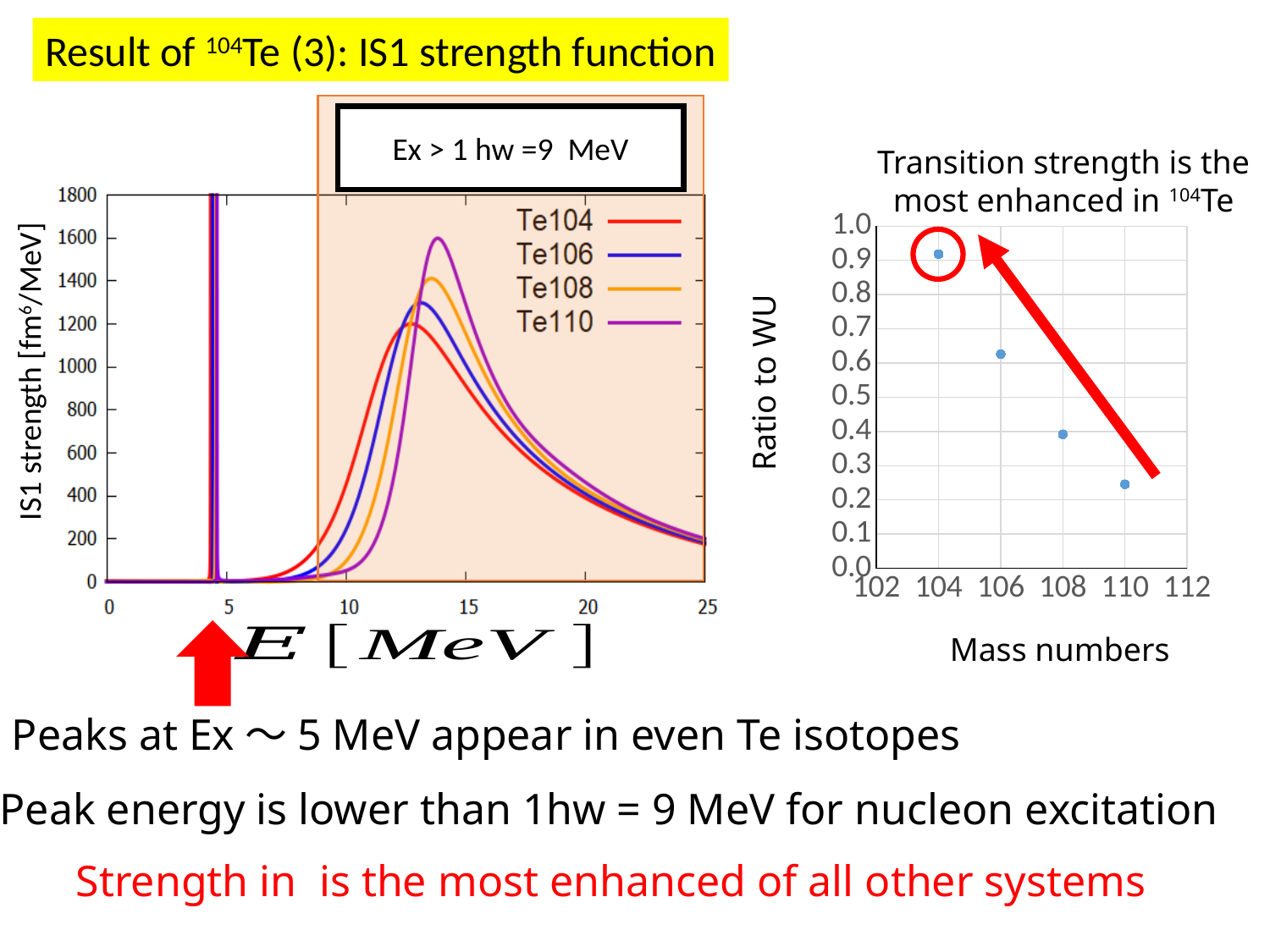
On the right chart (Ratio to WU vs Mass numbers), which mass number has the lowest ratio to WU? 110 On the right chart (Ratio to WU vs Mass numbers), is the ratio to WU for mass number 110 greater or less than 0.3? less On the left chart (IS1 strength vs E [MeV]), what colour is the Te104 series in the legend? red On the right chart (Ratio to WU vs Mass numbers), which mass number has the highest ratio to WU? 104 On the right chart (Ratio to WU vs Mass numbers), is the ratio to WU for mass number 108 greater or less than 0.5? less On the right chart (Ratio to WU vs Mass numbers), is the ratio to WU for mass number 104 greater or less than 0.8? greater On the left chart (IS1 strength vs E [MeV]), which series reaches the highest peak in the broad bump above 9 MeV? Te110 On the left chart (IS1 strength vs E [MeV]), how many series does the legend list? 4 On the right chart (Ratio to WU vs Mass numbers), does the ratio to WU rise or fall as the mass number increases? fall On the right chart (Ratio to WU vs Mass numbers), how many data points are plotted? 4 On the right chart (Ratio to WU vs Mass numbers), which has a larger ratio to WU, mass number 106 or mass number 108? 106